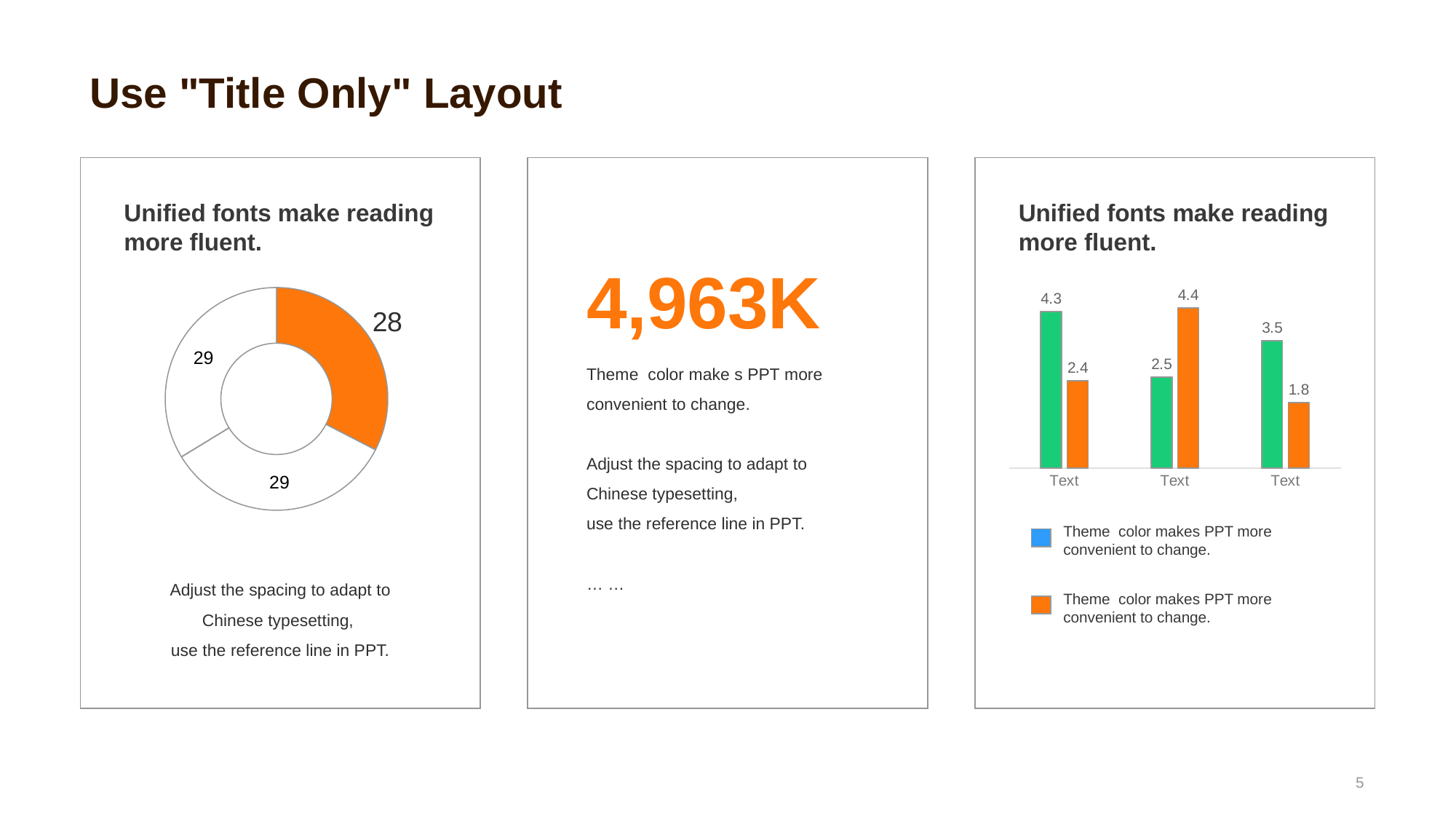
On the doughnut chart on the left, what is the difference between a slice labelled 29 and the slice labelled 28? 1 On the bar chart on the right, what is the value of the orange bar in the second group? 4.4 On the bar chart on the right, in the third group, which bar is larger, the green or the orange? Green What kind of chart is shown on the right side of the slide? Bar chart On the doughnut chart on the left, what is the total of all the slice values? 86 On the doughnut chart on the left, what is the value of the orange slice? 28 On the bar chart on the right, what is the lowest value shown? 1.8 On the doughnut chart on the left, which slice has the smallest value? The orange slice (28) On the bar chart on the right, what is the difference between the green and orange bars in the first group? 1.9 On the bar chart on the right, what is the value of the green bar in the first group? 4.3 On the bar chart on the right, how many groups of bars are there along the x axis? 3 On the doughnut chart on the left, how many slices are there? 3